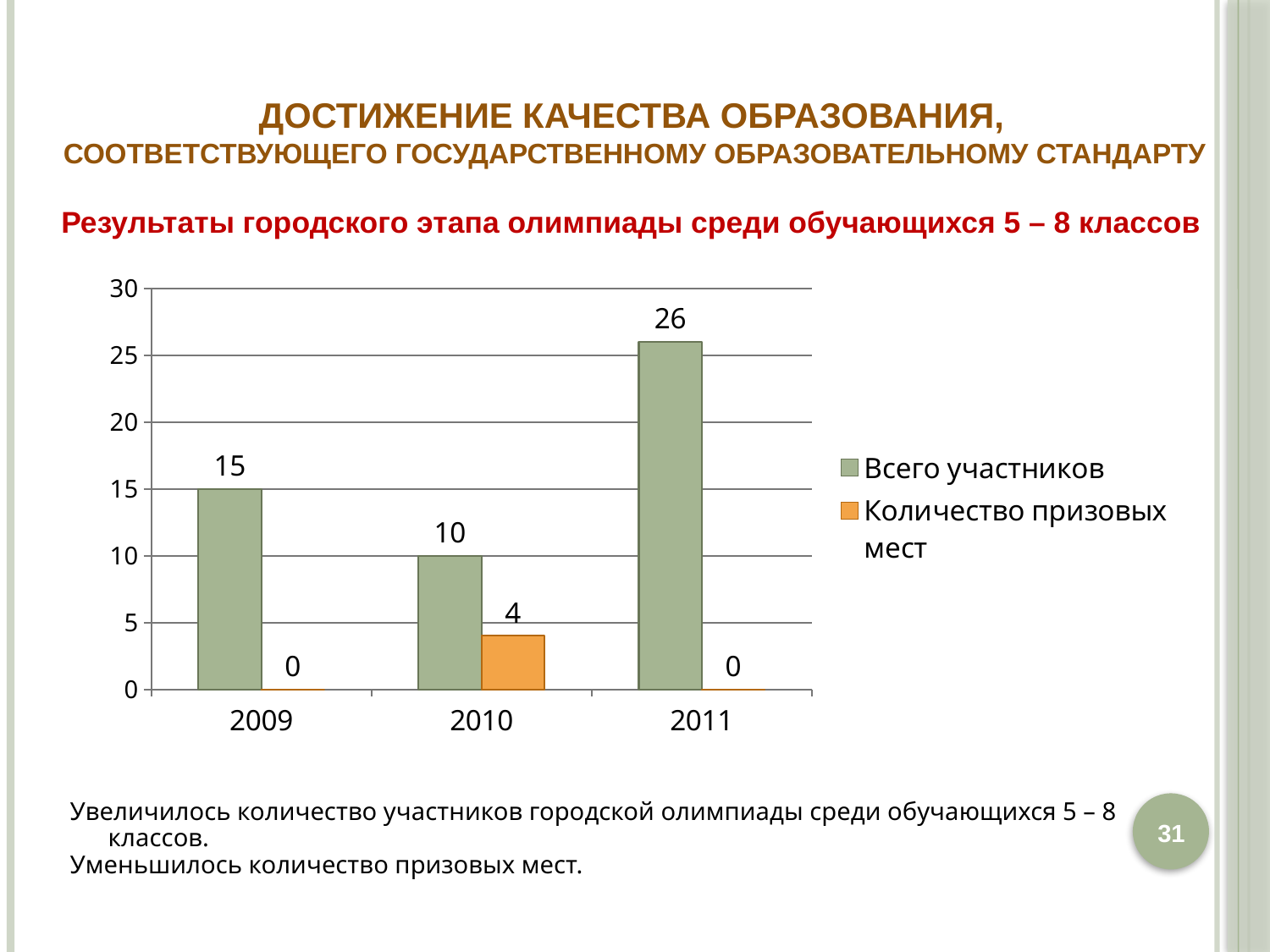
What is the value of 'Всего участников' for 2011? 26 Which year has the highest value for 'Всего участников'? 2011 Which year has the lowest value for 'Всего участников'? 2010 What is the value of 'Всего участников' for 2009? 15 What is the value of 'Количество призовых мест' for 2010? 4 What is the value of 'Количество призовых мест' for 2009? 0 What is the difference between 'Всего участников' in 2011 and in 2009? 11 Which is larger: 'Всего участников' in 2009 or in 2010? 2009 What kind of chart is shown on the slide? bar chart Is the value for 'Всего участников' in 2011 greater or less than 25? greater How many series does the legend list? 2 How many years are shown on the x axis? 3